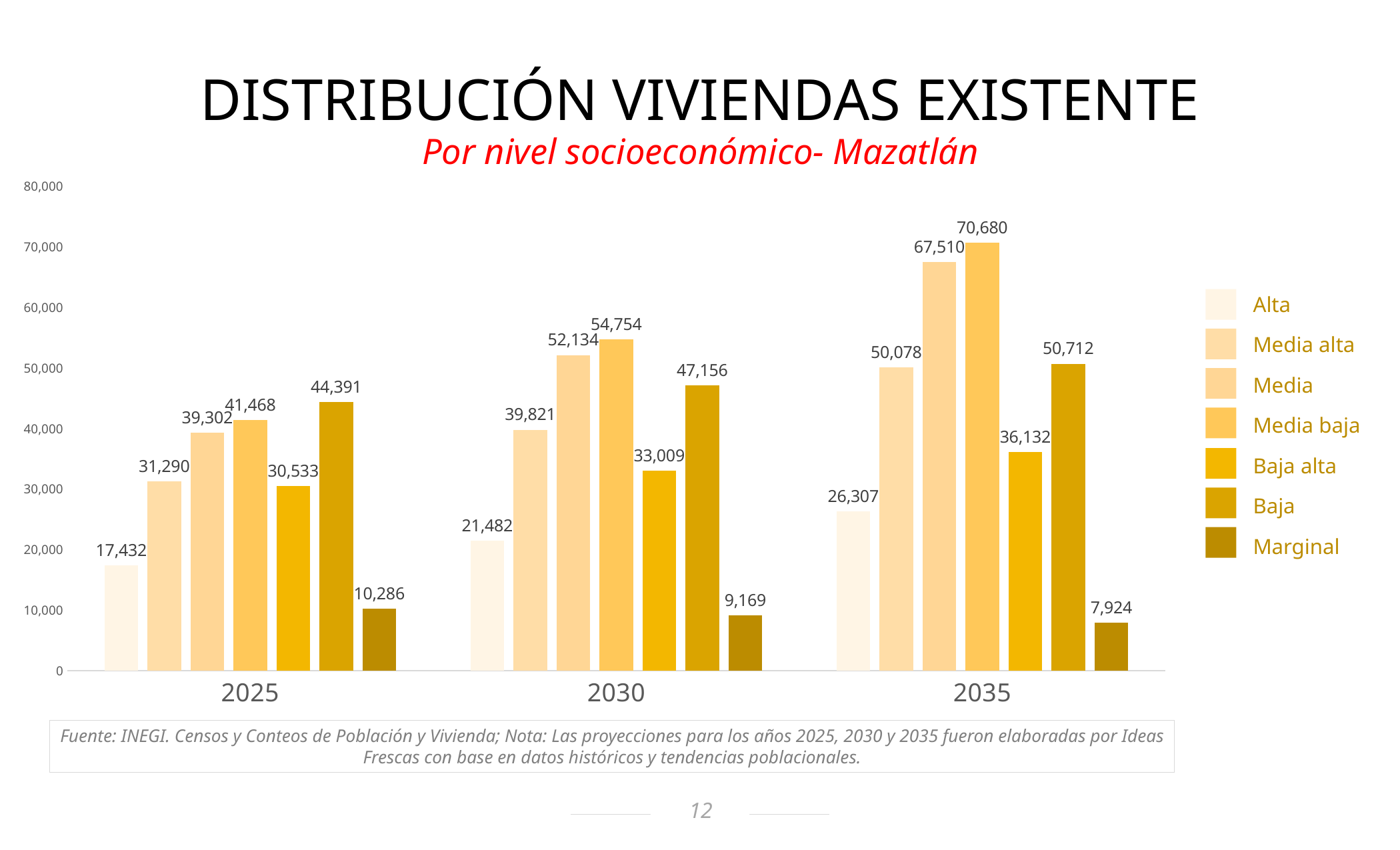
What is the value for Marginal in 2025? 10,286 Does the Media alta value rise or fall from 2025 to 2035? Rises What is the subtitle shown in red below the chart title? Por nivel socioeconómico- Mazatlán What is the difference between the Media and Media alta values in 2030? 12,313 Which is larger: Alta in 2030 or Baja alta in 2025? Baja alta in 2025 How many series does the legend list? 7 What kind of chart is shown on the slide? Bar chart What is the difference between the Baja value in 2035 and the Baja value in 2025? 6,321 What is the value for Media baja in 2035? 70,680 Which socioeconomic level has the lowest value in 2035? Marginal Which socioeconomic level has the highest value in 2030? Media baja How many years are shown on the x axis? 3